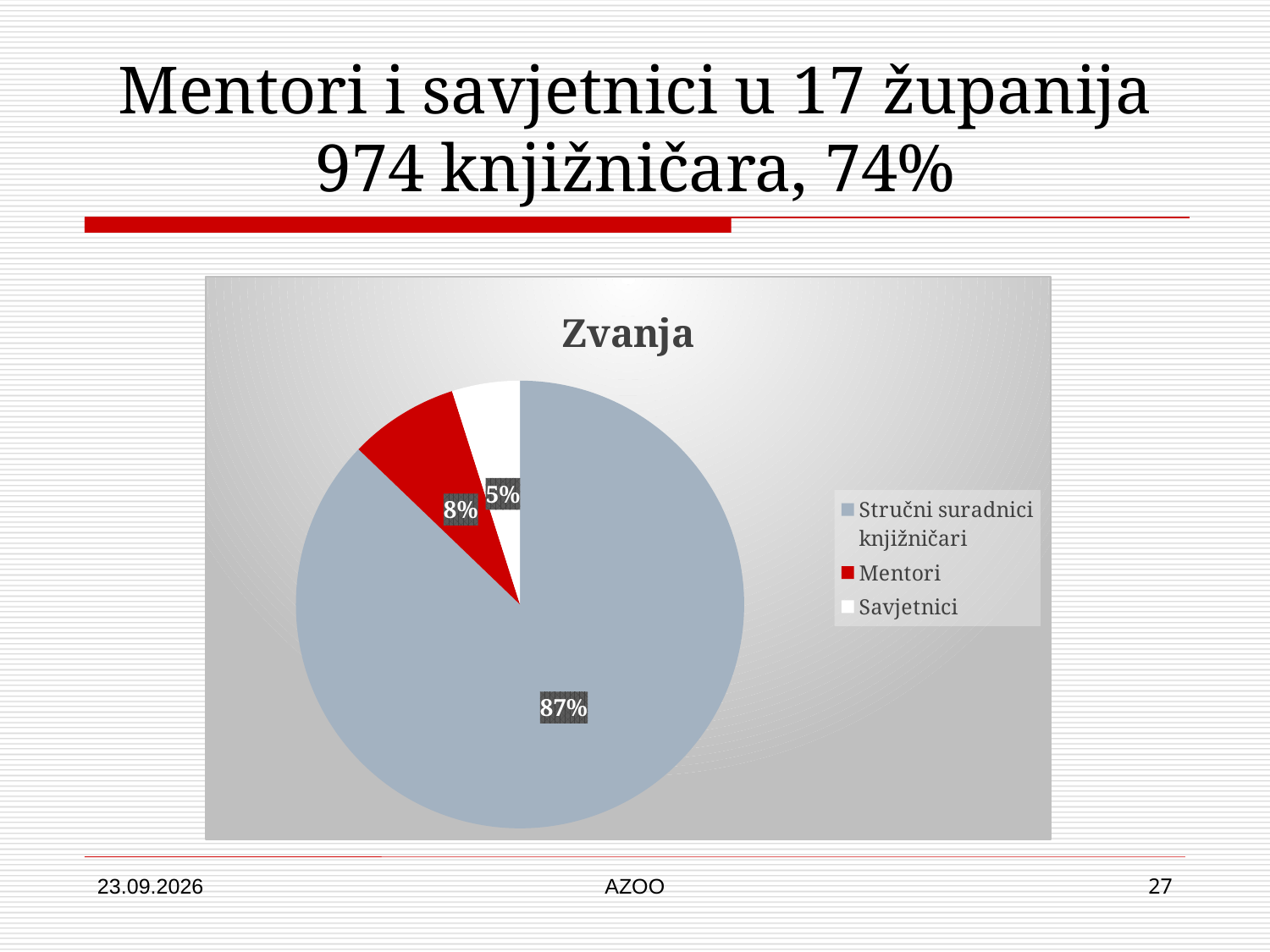
Which slice is larger, Mentori or Savjetnici? Mentori What kind of chart is shown on the slide? pie chart What is the difference in percentage points between the Stručni suradnici knjižničari and Mentori slices? 79 What share of the pie does Savjetnici have? 5% What colour is the Mentori slice? red What share of the pie does Stručni suradnici knjižničari have? 87% How many categories does the pie chart show? 3 What is the difference in percentage points between the Mentori and Savjetnici slices? 3 Which category has the smallest slice of the pie? Savjetnici Which category has the largest slice of the pie? Stručni suradnici knjižničari What share of the pie does Mentori have? 8% What is the title of the chart? Zvanja